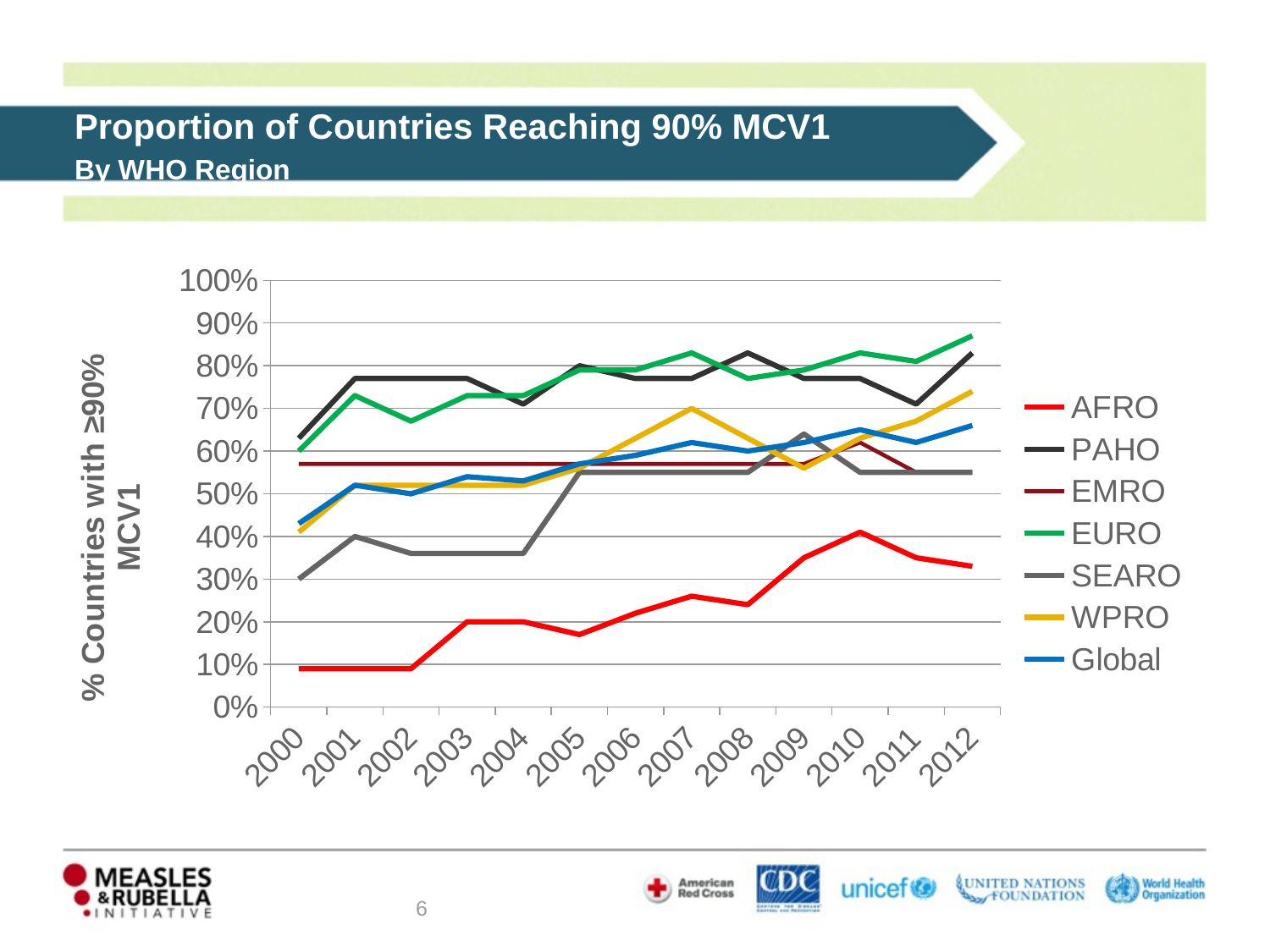
Is the value for Global in 2012 greater or less than 60%? greater Does the AFRO line rise or fall from 2000 to 2010? rise In 2005, which is larger: the value for PAHO or the value for AFRO? PAHO How many series does the legend list? 7 How many years are shown along the x axis? 13 Is the value for AFRO in 2010 greater or less than 30%? greater Is the value for EURO in 2012 greater or less than 80%? greater What is the title of the vertical axis? % Countries with ≥90% MCV1 What kind of chart is shown on the slide? line chart Which region has the lowest proportion of countries reaching 90% MCV1 in 2012? AFRO Which region has the lowest value in 2000? AFRO